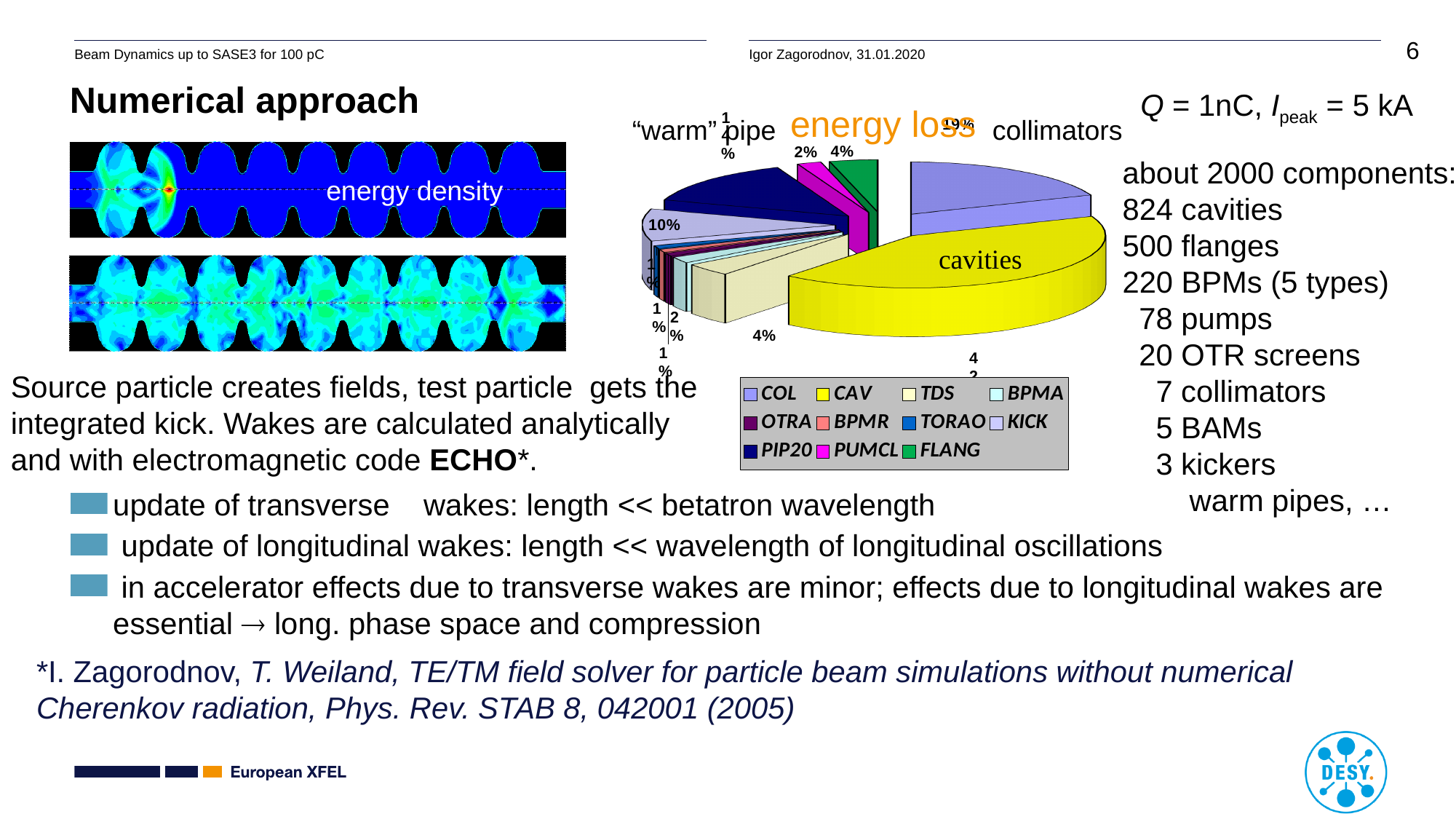
Which component is the yellow slice of the energy loss pie chart labelled as on the slide? cavities In the energy loss pie chart, what percentage is shown for FLANG? 4% How many entries does the legend of the energy loss pie chart list? 11 In the energy loss pie chart, what is the difference between the PIP20 share and the FLANG share? 10% What is the title of the pie chart on the slide? energy loss In the energy loss pie chart, what percentage is shown for TDS? 4% In the energy loss pie chart, which is larger: the FLANG slice or the PUMCL slice? FLANG In the energy loss pie chart, what percentage is shown for PUMCL? 2% In the energy loss pie chart, what percentage is shown for PIP20? 14% Which legend entry corresponds to the largest slice of the energy loss pie chart? CAV What kind of chart is used to show the energy loss breakdown? pie chart In the energy loss pie chart, which is larger: the PIP20 slice or the FLANG slice? PIP20